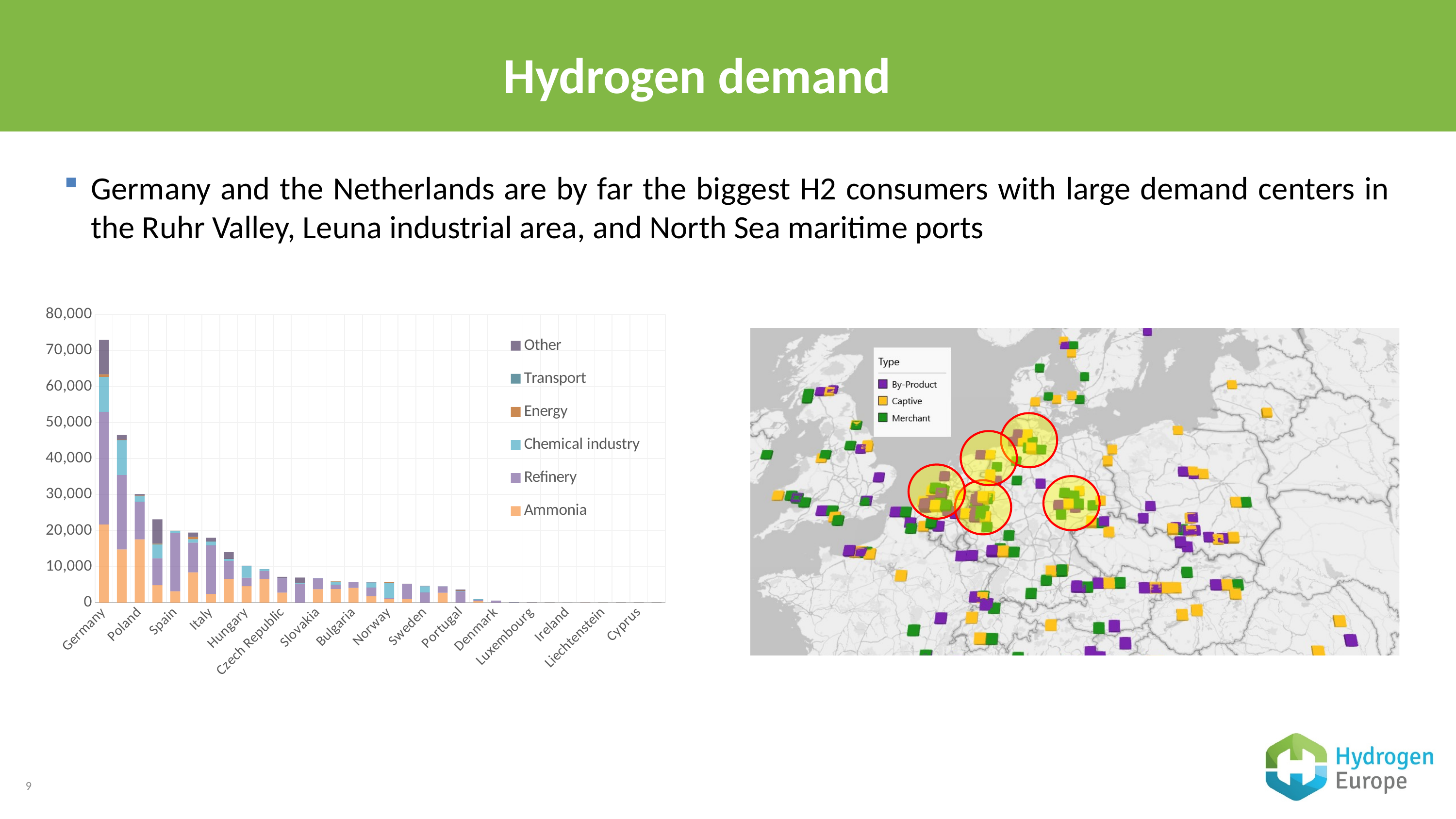
How many series does the legend of the bar chart list? 6 Which has the larger total bar, Germany or Poland? Germany Do the total bar values rise or fall moving from left to right along the x axis? Fall Which has the larger total bar, Spain or Italy? Spain Is the total value for Germany greater or less than 60,000? greater Is the total value for Poland greater or less than 50,000? less What kind of chart is shown on the left of the slide? Stacked bar chart Is the total value for Poland greater or less than 40,000? less Which series is listed at the bottom of the bar chart's legend? Ammonia Which country has the highest total bar in the bar chart? Germany